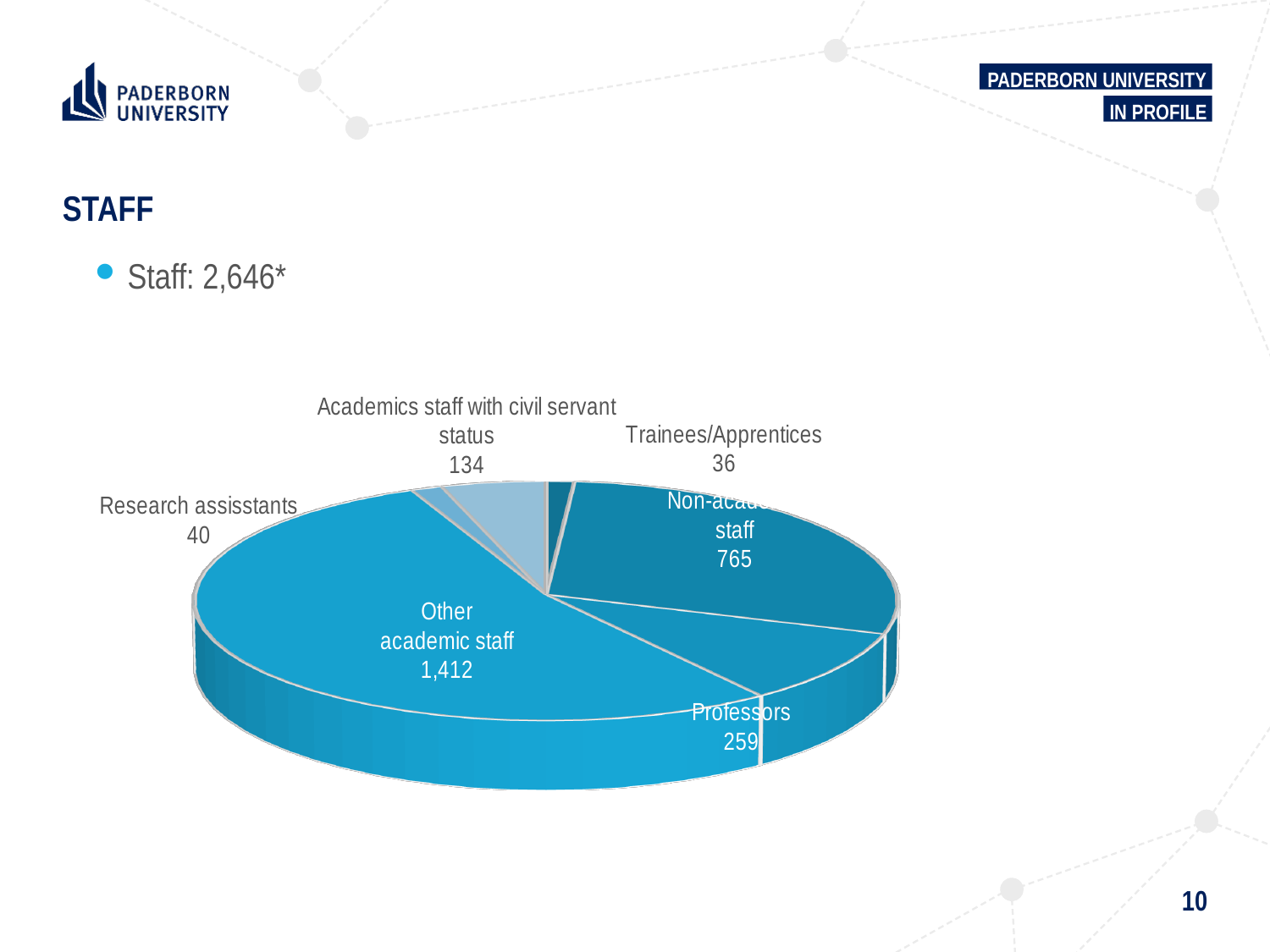
Which category has the largest slice of the pie? Other academic staff How many categories does the pie chart show? 6 What is the difference between Non-academic staff and Professors? 506 What is the value for Research assistants? 40 What is the value for Academics staff with civil servant status? 134 What is the value for Other academic staff? 1,412 Which category has the smallest slice of the pie? Trainees/Apprentices What type of chart is shown on the slide? Pie chart Which is larger, Academics staff with civil servant status or Research assistants? Academics staff with civil servant status What total staff number is stated on the slide? 2,646 What is the value for Trainees/Apprentices? 36 What is the value for Professors? 259